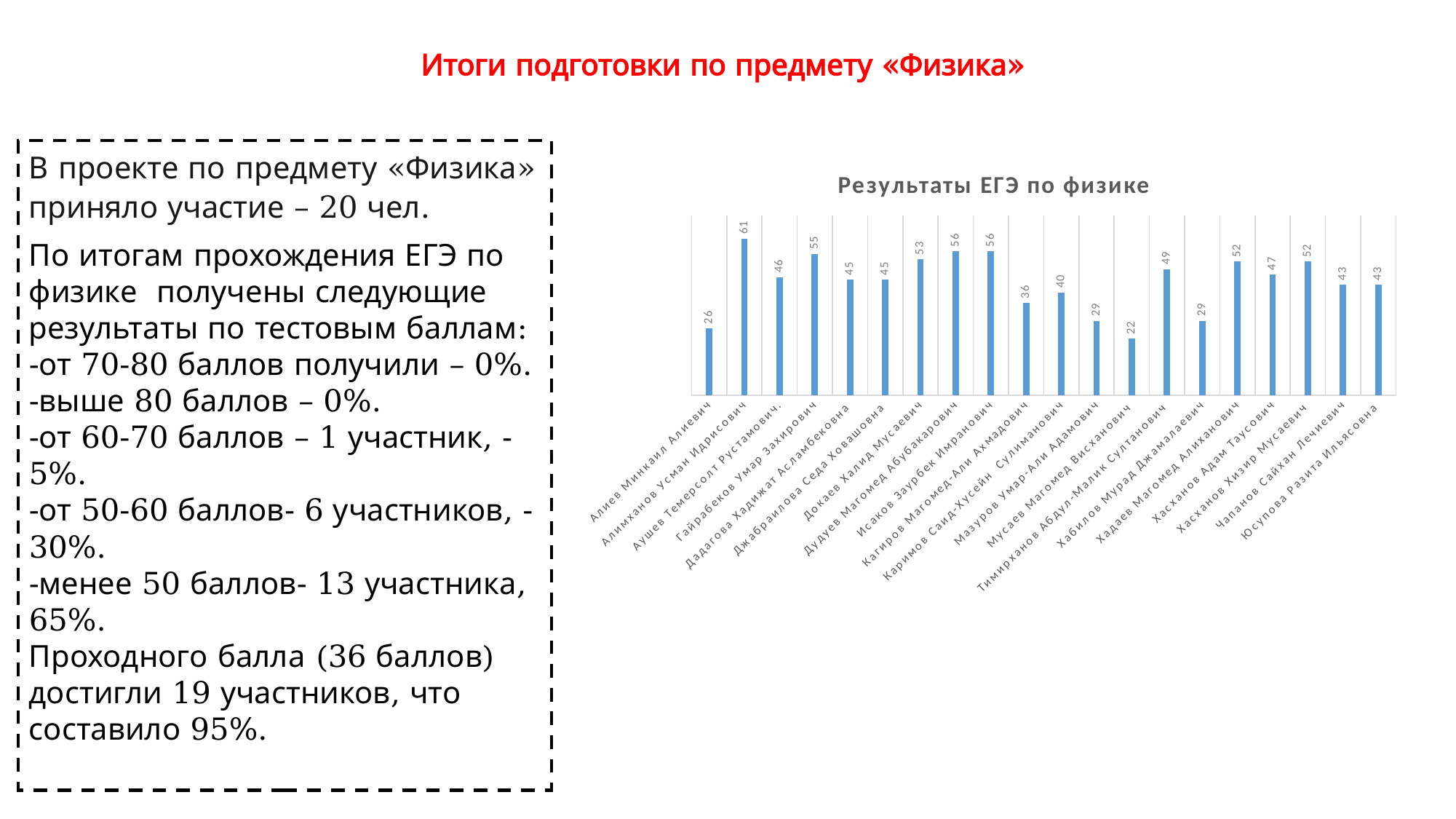
Which participant has the lowest score in the chart? Мусаев Магомед Висханович Who has the higher score, Гайрабеков Умар Захирович or Докаев Халид Мусаевич? Гайрабеков Умар Захирович What is the value for Тимирханов Абдул-Малик Султанович? 49 What is the difference between the scores of Кагиров Магомед-Али Ахмадович and Каримов Саид-Хусейн Сулиманович? 4 Which participant has the highest score in the chart? Алимханов Усман Идрисович How many participants (bars) are shown in the chart? 20 What is the value for Мусаев Магомед Висханович? 22 What is the difference between the scores of Алимханов Усман Идрисович and Алиев Минкаил Алиевич? 35 What is the value for Юсупова Разита Ильясовна? 43 What is the value for Алимханов Усман Идрисович? 61 What is the title of the chart? Результаты ЕГЭ по физике What type of chart is shown on the slide? bar chart